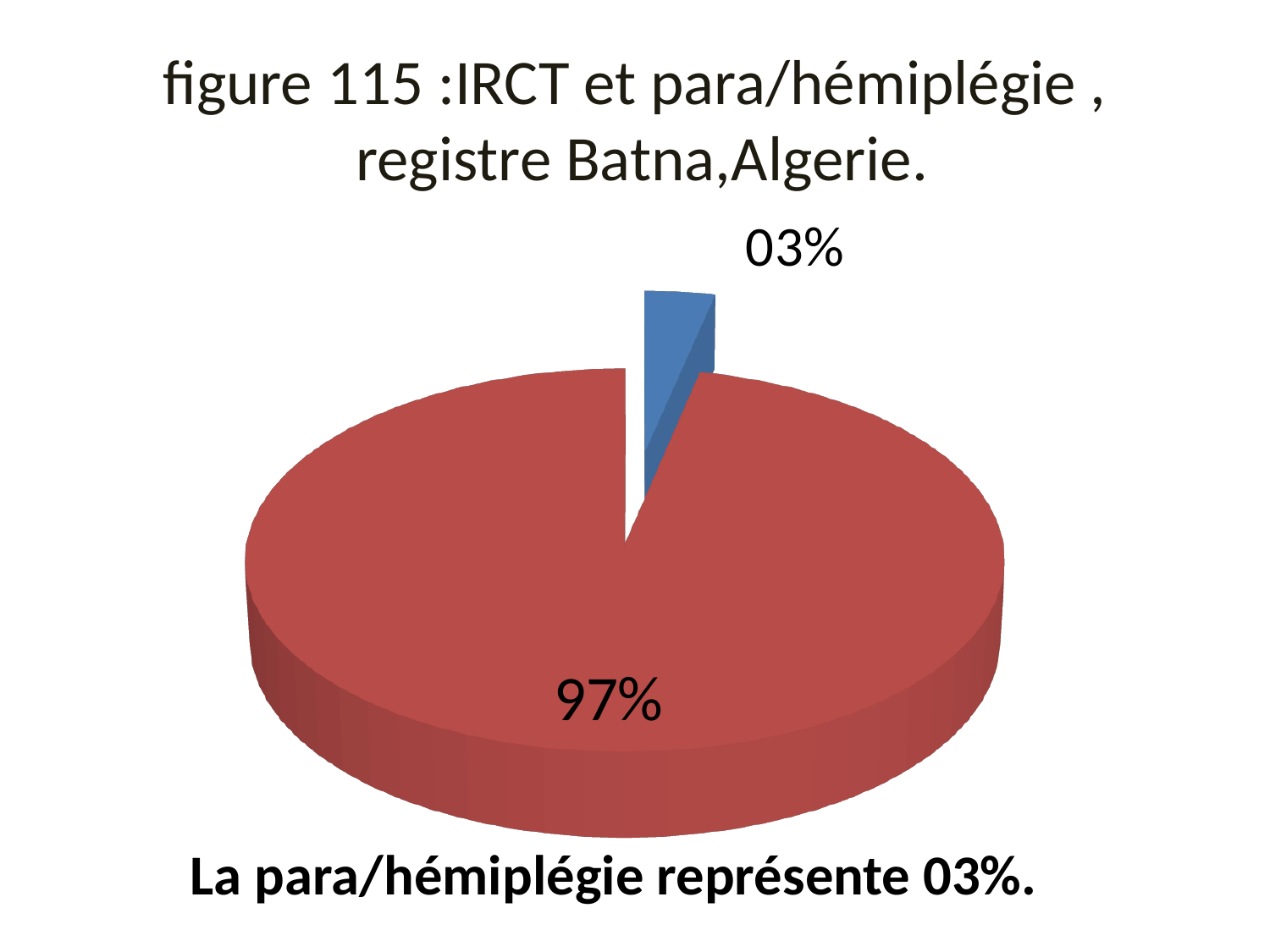
What is the largest value shown on the pie chart? 97% What kind of chart is shown on the slide? pie chart According to the slide, what share does para/hémiplégie represent? 03% What is the figure number given in the chart title? figure 115 What percentage is shown on the red slice of the pie chart? 97% What is the difference between the two percentages shown on the pie chart? 94% How many slices does the pie chart have? 2 What percentage is shown on the blue slice of the pie chart? 03% What is the smallest value shown on the pie chart? 03% Which registry is named in the chart title? registre Batna,Algerie Which slice is larger, the blue slice or the red slice? the red slice